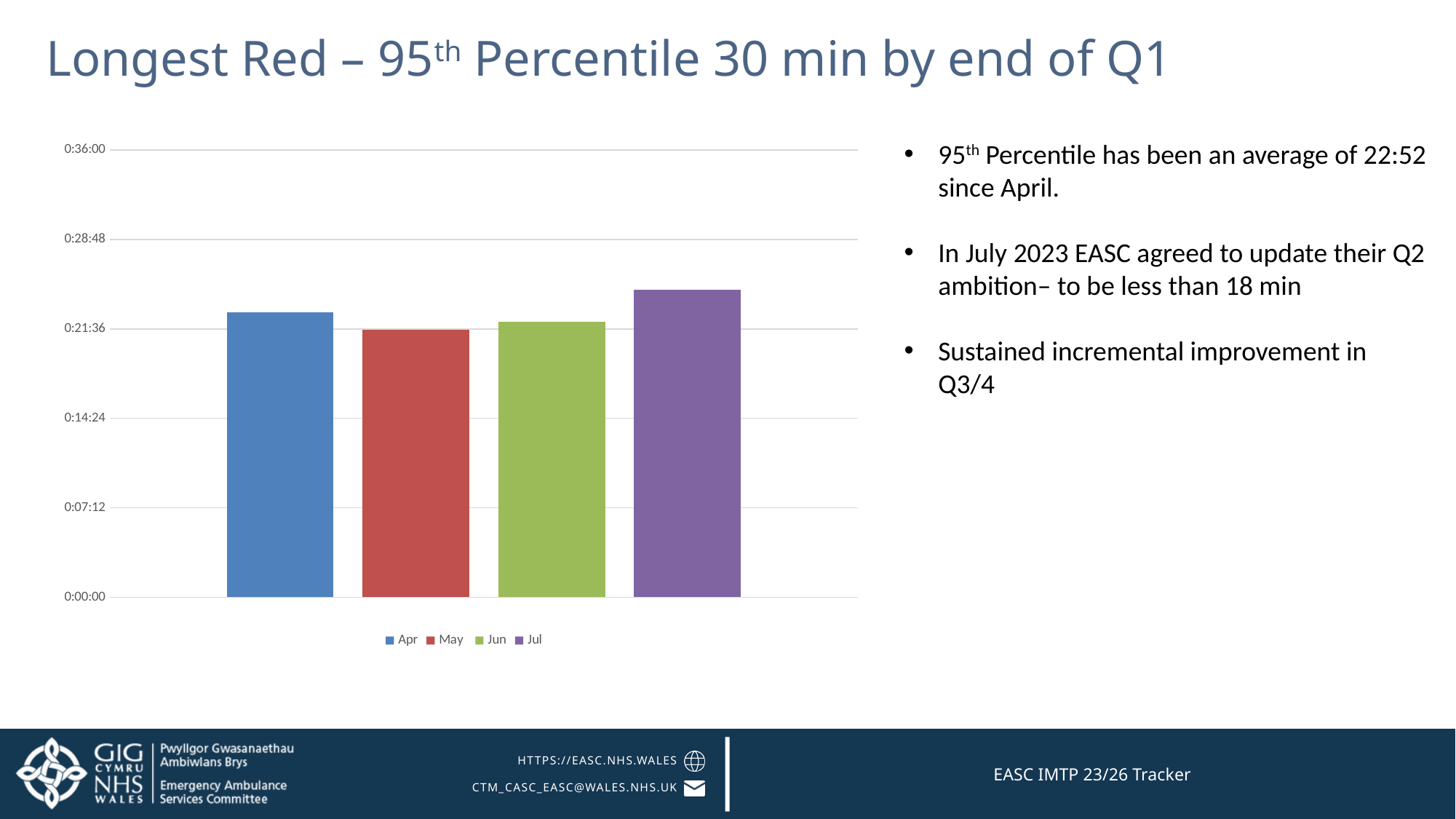
Is the value for Jul greater or less than 0:21:36? greater What colour is the bar for Jul? Purple Which is larger, the value for Jul or the value for Apr? Jul Is the value for Apr greater or less than 0:21:36? greater How many bars are plotted in the chart? 4 What are the legend entries of the chart, in order? Apr, May, Jun, Jul Is the value for May greater or less than 0:14:24? greater Which is larger, the value for Apr or the value for May? Apr Which month has the highest bar in the chart? Jul What kind of chart is shown on the slide? Bar chart How many entries does the chart legend list? 4